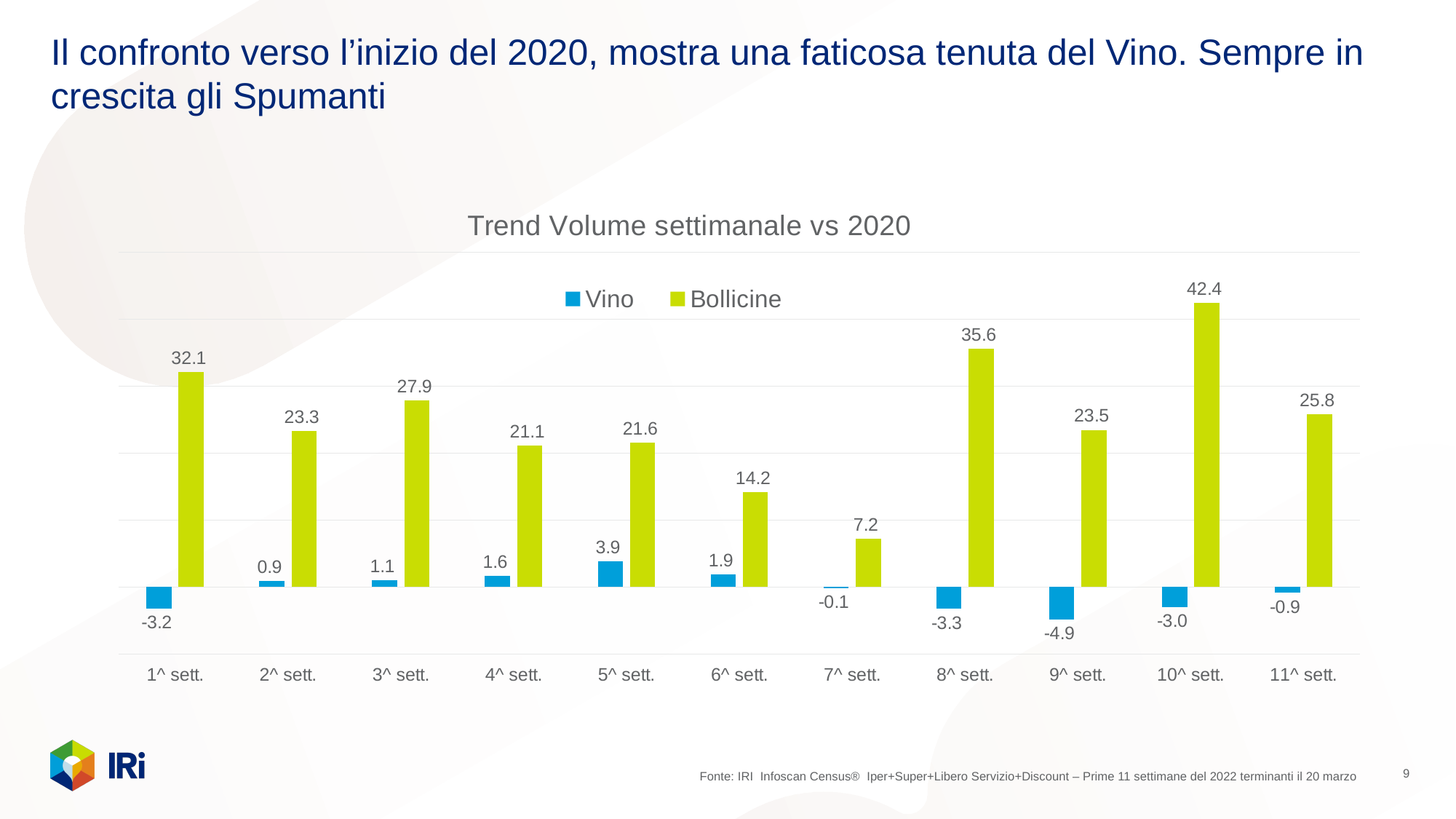
How many series does the legend list? 2 What is the difference between the Bollicine values in 10^ sett. and 8^ sett.? 6.8 What is the title of the chart? Trend Volume settimanale vs 2020 What is the value for Bollicine in 10^ sett.? 42.4 Which week has the lowest Bollicine value? 7^ sett. What is the value for Vino in 9^ sett.? -4.9 How many weeks are shown on the x axis? 11 Which week has the highest Bollicine value? 10^ sett. Which is larger, the Bollicine value in 1^ sett. or in 3^ sett.? 1^ sett. Which week has the lowest Vino value? 9^ sett. What is the value for Vino in 5^ sett.? 3.9 What kind of chart is shown on the slide? bar chart